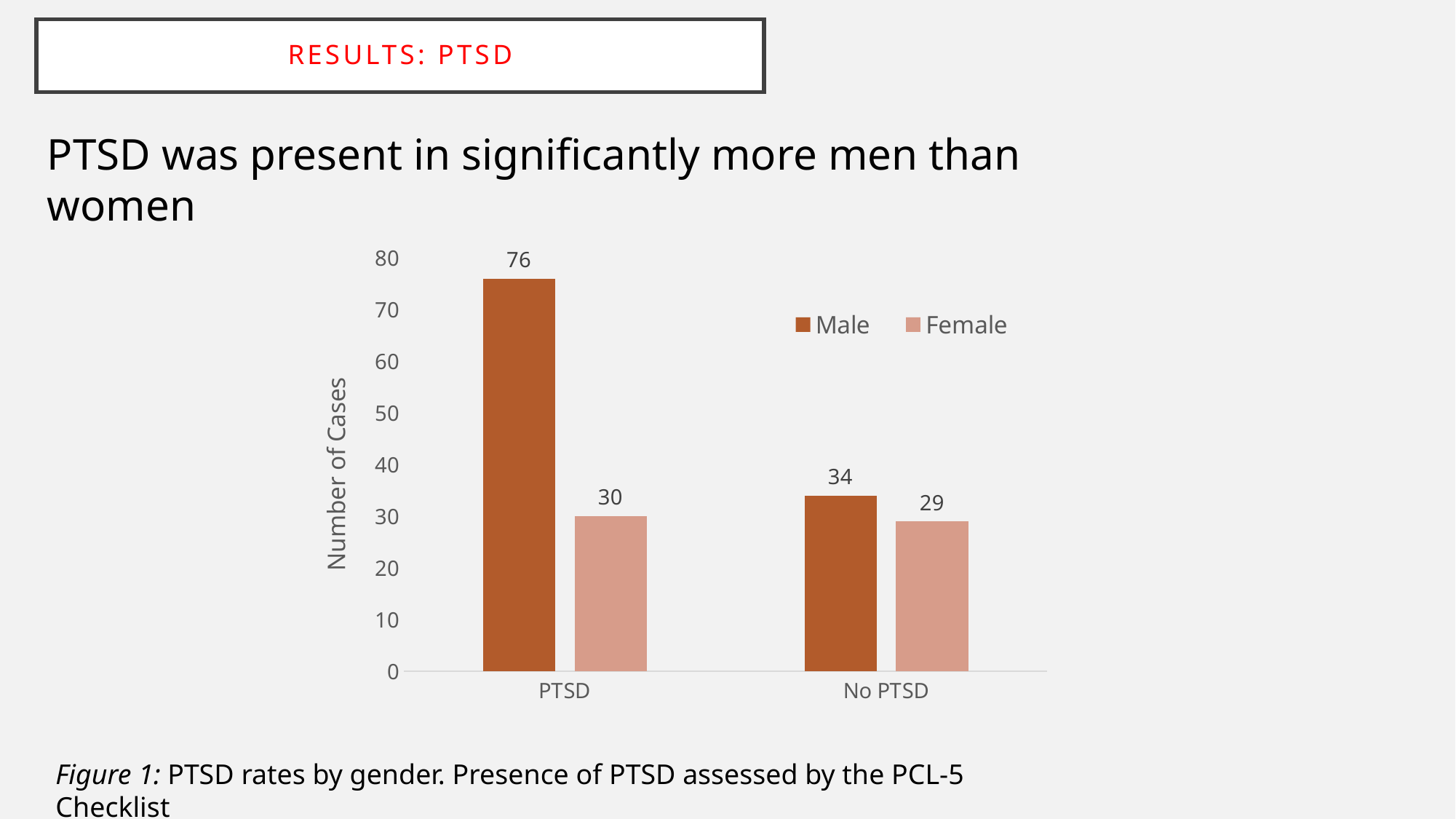
How many series does the legend list? 2 What kind of chart is shown on the slide? Bar chart What is the number of Male cases in the No PTSD category? 34 What is the difference between the Male and Female values in the PTSD category? 46 Which is larger: the Male value for PTSD or the Male value for No PTSD? Male value for PTSD Which bar has the highest value on the chart? Male, PTSD What is the difference between the Male values for PTSD and No PTSD? 42 What is the number of Female cases in the PTSD category? 30 What is the number of Female cases in the No PTSD category? 29 How many categories are shown on the x axis? 2 Which bar has the lowest value on the chart? Female, No PTSD What is the number of Male cases in the PTSD category? 76